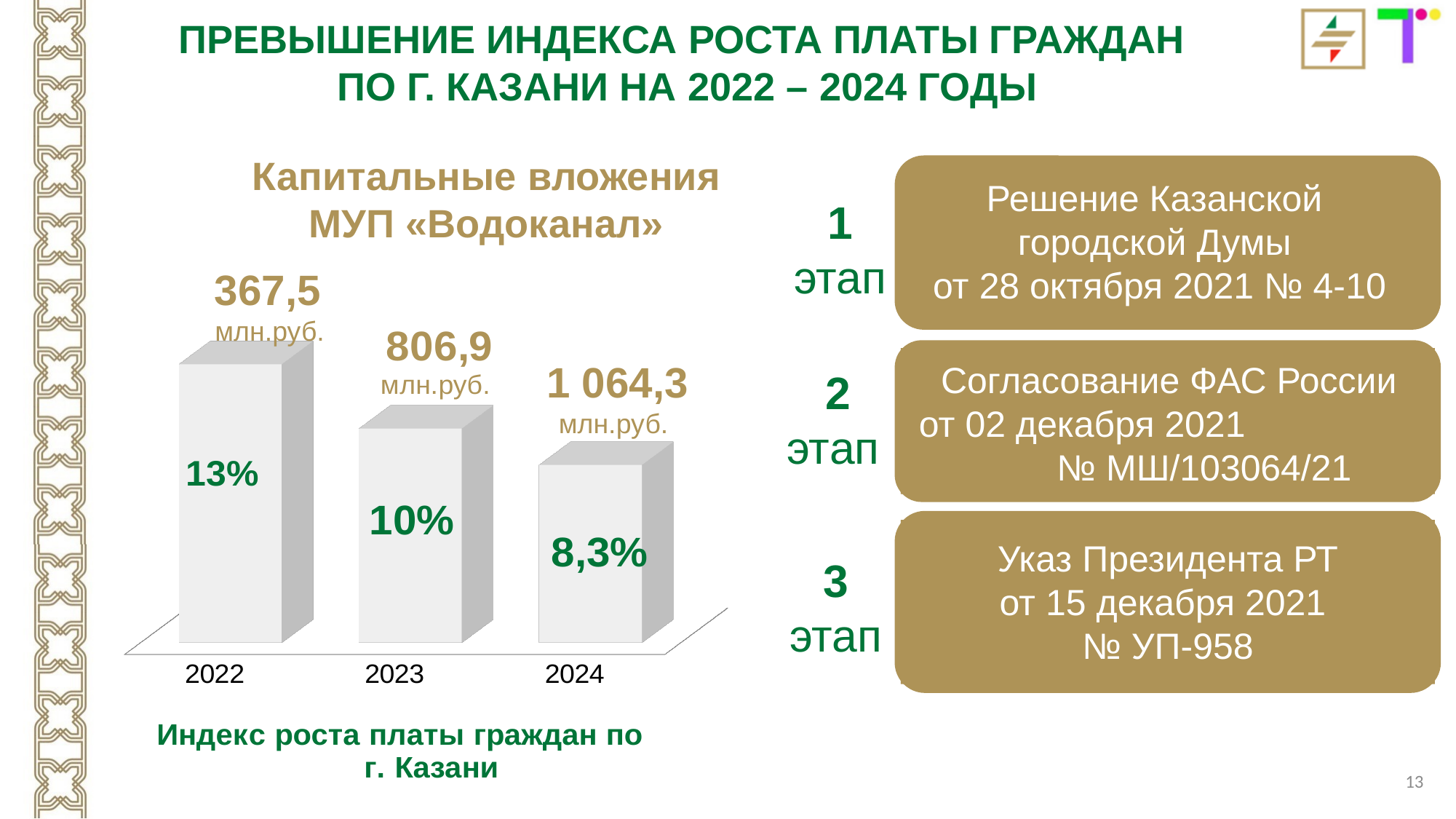
What is the index of growth of citizens' payment (percentage shown on the bar) for 2022? 13% What is the percentage shown on the bar for 2024? 8,3% By how much do the capital investments for 2023 exceed those for 2022 (in млн.руб.)? 439,4 Which year has the lowest percentage on its bar? 2024 Which year has the highest percentage on its bar? 2022 Do the bar heights (percentages) rise or fall from 2022 to 2024? Fall Which year has larger capital investments, 2022 or 2024? 2024 What kind of chart is shown on the slide? Bar chart How many years (bars) are shown in the chart? 3 What is the difference between the percentages shown for 2022 and 2023? 3% What are the capital investments shown above the 2024 bar? 1 064,3 млн.руб. What are the capital investments of МУП «Водоканал» shown above the 2023 bar? 806,9 млн.руб.